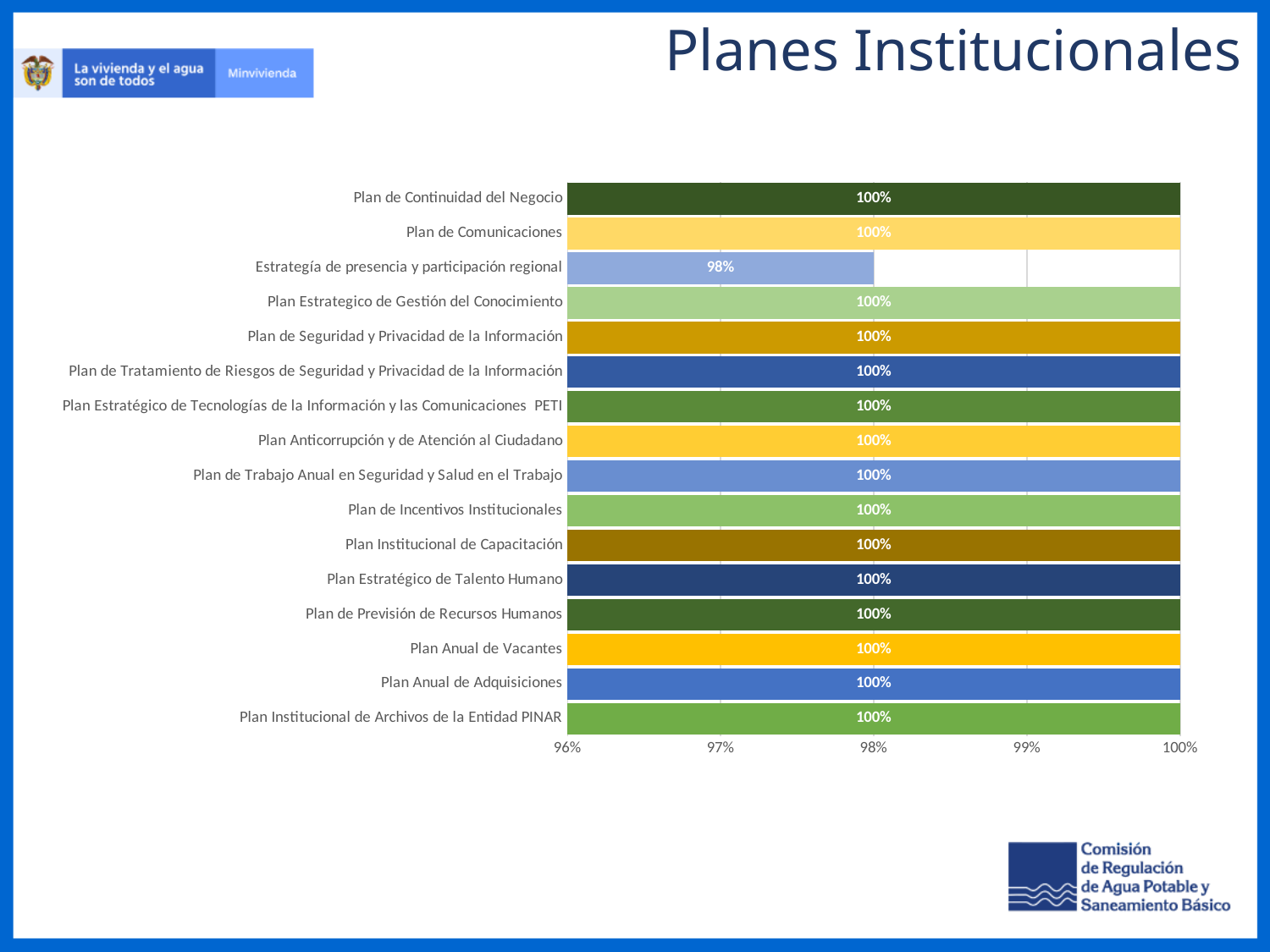
What kind of chart is shown on the slide? bar chart What is the difference between the value for Plan de Comunicaciones and the value for Estrategía de presencia y participación regional? 2% Which is larger: the value for Plan Anual de Vacantes or the value for Estrategía de presencia y participación regional? Plan Anual de Vacantes What is the title of the slide containing the chart? Planes Institucionales Which plan has the lowest value in the chart? Estrategía de presencia y participación regional Is the value for Estrategía de presencia y participación regional greater or less than 99%? less How many plans (categories) are plotted in the chart? 16 How many plans in the chart have a value of 100%? 15 What is the value for Plan de Continuidad del Negocio? 100% What is the value for Plan Institucional de Archivos de la Entidad PINAR? 100% What is the lowest value shown on the horizontal axis of the chart? 96% What is the value for Estrategía de presencia y participación regional? 98%